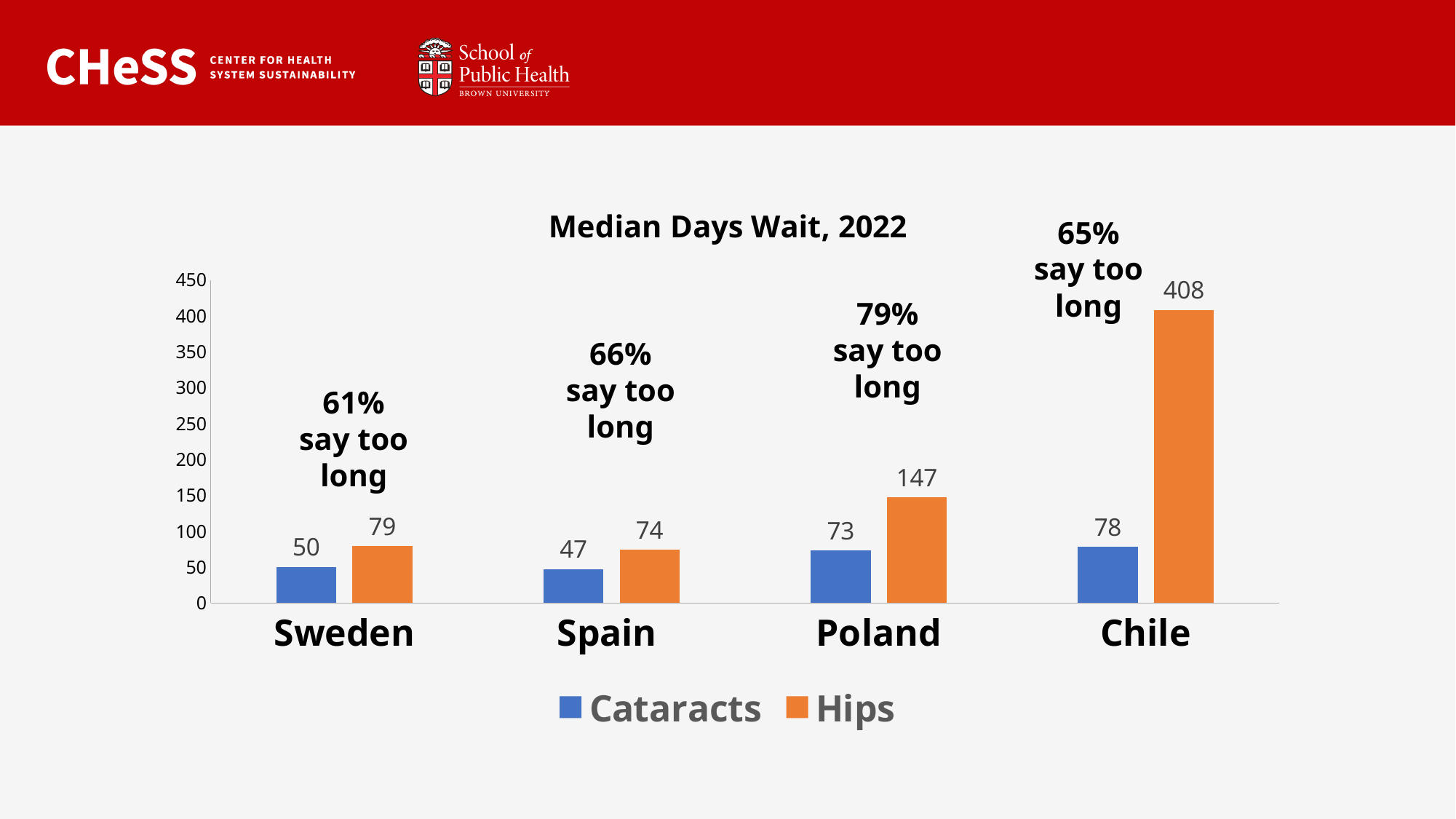
What percentage of people in Poland say the wait is too long, according to the annotation above the bars? 79% What is the difference in median days wait for Hips between Poland and Sweden? 68 How many series does the legend list? 2 What kind of chart is shown on the slide? Bar chart What is the median days wait for Hips in Poland? 147 What is the median days wait for Hips in Chile? 408 Which is larger, the Cataracts wait in Chile or the Cataracts wait in Poland? Chile What is the median days wait for Cataracts in Spain? 47 Which country has the highest median days wait for Hips? Chile How many countries are shown on the x axis? 4 What is the difference between the Hips and Cataracts median days wait in Chile? 330 Which country has the lowest median days wait for Cataracts? Spain